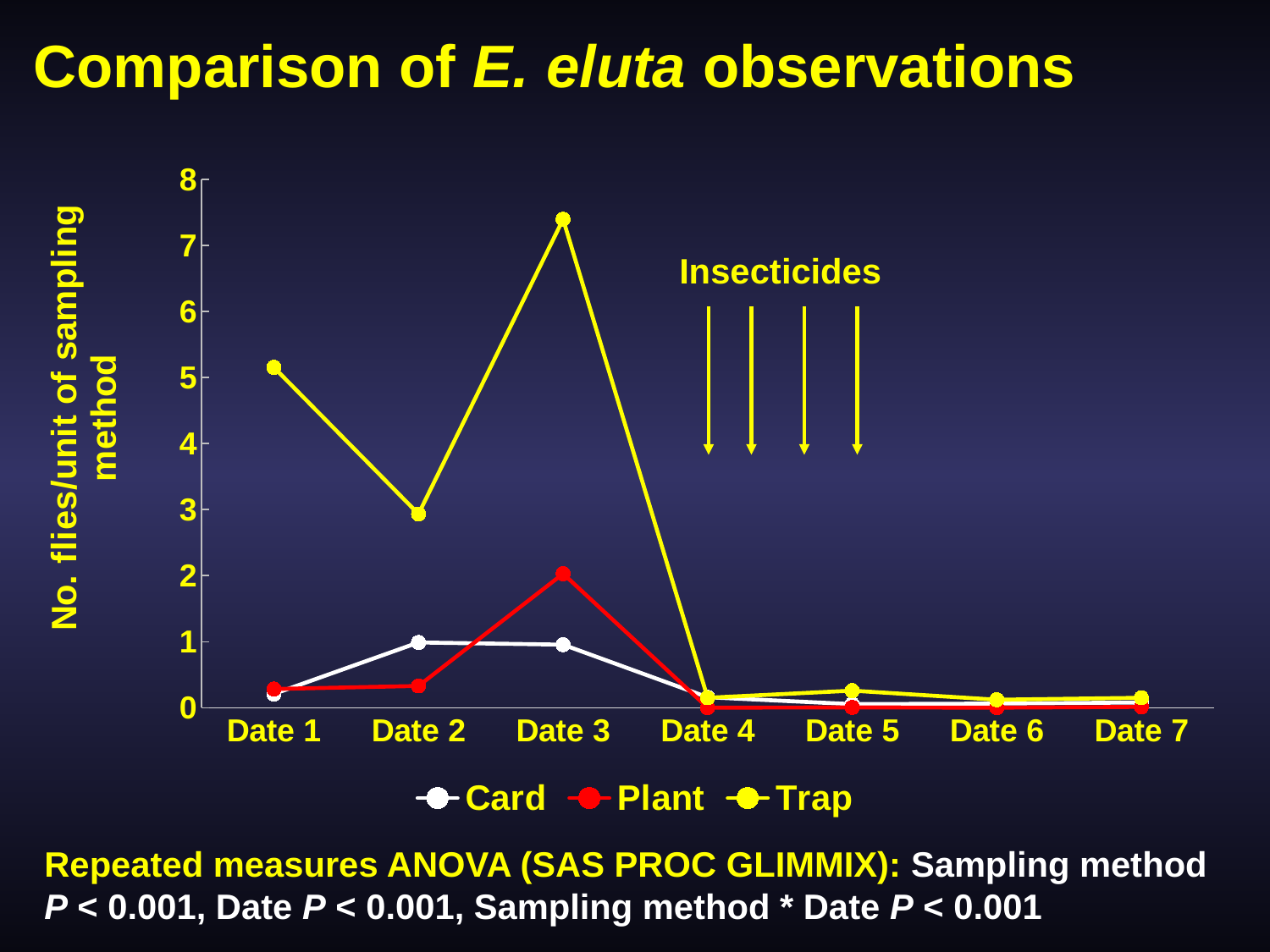
On which date does the Trap series reach its highest value? Date 3 How many dates are plotted along the x axis? 7 Is the value for Trap on Date 1 greater or less than 5? greater What annotation is written above the arrows pointing at Dates 4 and 5? Insecticides How many series does the legend list? 3 Which series has the larger value on Date 3, Trap or Plant? Trap Is the value for Plant on Date 3 greater or less than 1? greater Does the Trap series rise or fall from Date 3 to Date 4? fall What is the label of the y axis? No. flies/unit of sampling method Is the value for Trap on Date 3 greater or less than 7? greater What kind of chart is shown on the slide? line chart